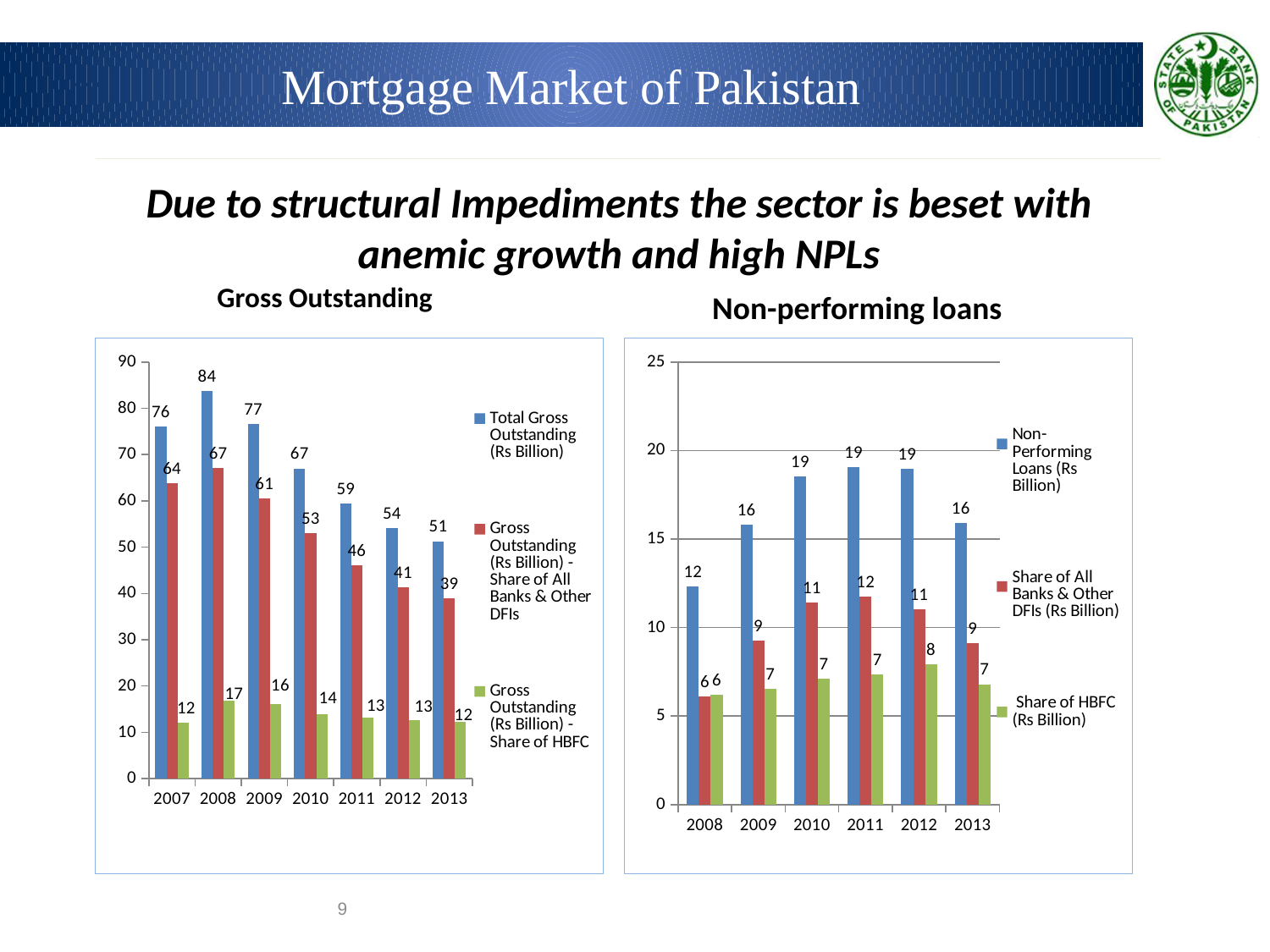
In the Non-performing loans chart, what is the Share of All Banks & Other DFIs value for 2011? 12 How many series does the legend of the Non-performing loans chart list? 3 In the Non-performing loans chart, what is the Non-Performing Loans (Rs Billion) value for 2008? 12 In the Gross Outstanding chart, what is the Share of HBFC value for 2010? 14 In the Gross Outstanding chart, does the Total Gross Outstanding series rise or fall from 2009 to 2013? fall In the Gross Outstanding chart, which year has the lowest Share of All Banks & Other DFIs value? 2013 In the Non-performing loans chart, which year has the highest Share of HBFC value? 2012 In the Non-performing loans chart, is the Non-Performing Loans value for 2009 larger or smaller than the value for 2013? They are equal (16) In the Gross Outstanding chart, which year has the highest Total Gross Outstanding value? 2008 In the Gross Outstanding chart, what is the difference between the Total Gross Outstanding values for 2008 and 2013? 33 In the Gross Outstanding chart, how many years are shown on the x axis? 7 In the Gross Outstanding chart, what is the Total Gross Outstanding (Rs Billion) value for 2008? 84